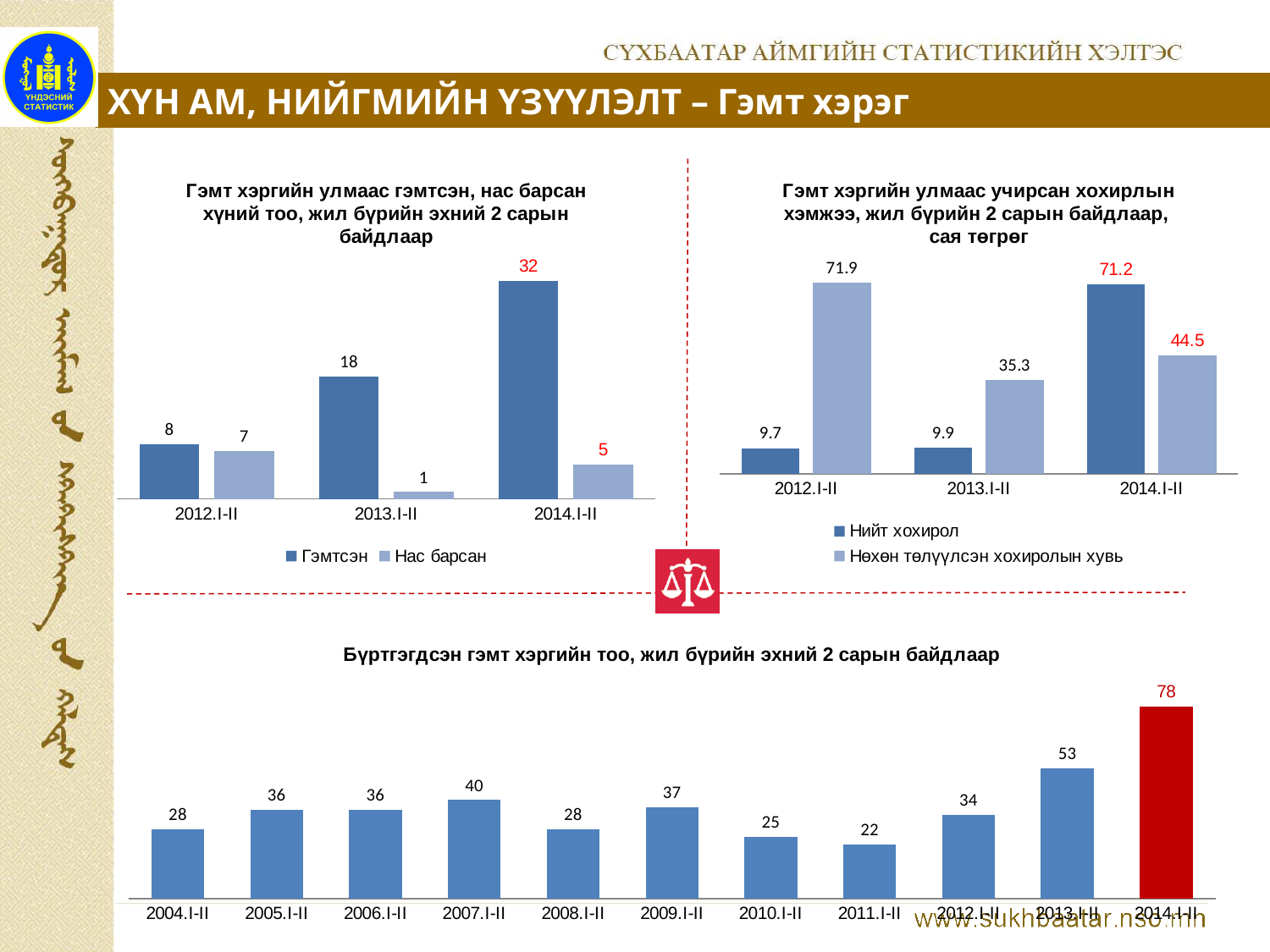
In the bottom chart (Бүртгэгдсэн гэмт хэргийн тоо), which period has the lowest value? 2011.I-II In the bottom chart (Бүртгэгдсэн гэмт хэргийн тоо), what is the value for 2014.I-II? 78 In the top-left chart (Гэмт хэргийн улмаас гэмтсэн, нас барсан хүний тоо), does the Гэмтсэн series rise or fall from 2012.I-II to 2014.I-II? rise In the top-right chart (Гэмт хэргийн улмаас учирсан хохирлын хэмжээ), what is the Нөхөн төлүүлсэн хохиролын хувь value for 2013.I-II? 35.3 In the top-left chart (Гэмт хэргийн улмаас гэмтсэн, нас барсан хүний тоо), what is the Гэмтсэн value for 2013.I-II? 18 In the top-left chart (Гэмт хэргийн улмаас гэмтсэн, нас барсан хүний тоо), what is the Нас барсан value for 2014.I-II? 5 What kind of chart is the bottom chart (Бүртгэгдсэн гэмт хэргийн тоо)? bar chart In the bottom chart (Бүртгэгдсэн гэмт хэргийн тоо), how many periods are shown on the x axis? 11 In the top-left chart (Гэмт хэргийн улмаас гэмтсэн, нас барсан хүний тоо), how many series does the legend list? 2 In the bottom chart (Бүртгэгдсэн гэмт хэргийн тоо), which is larger, the value for 2007.I-II or the value for 2009.I-II? 2007.I-II In the top-right chart (Гэмт хэргийн улмаас учирсан хохирлын хэмжээ), what is the Нийт хохирол value for 2014.I-II? 71.2 In the bottom chart (Бүртгэгдсэн гэмт хэргийн тоо), what is the difference between the values for 2014.I-II and 2013.I-II? 25